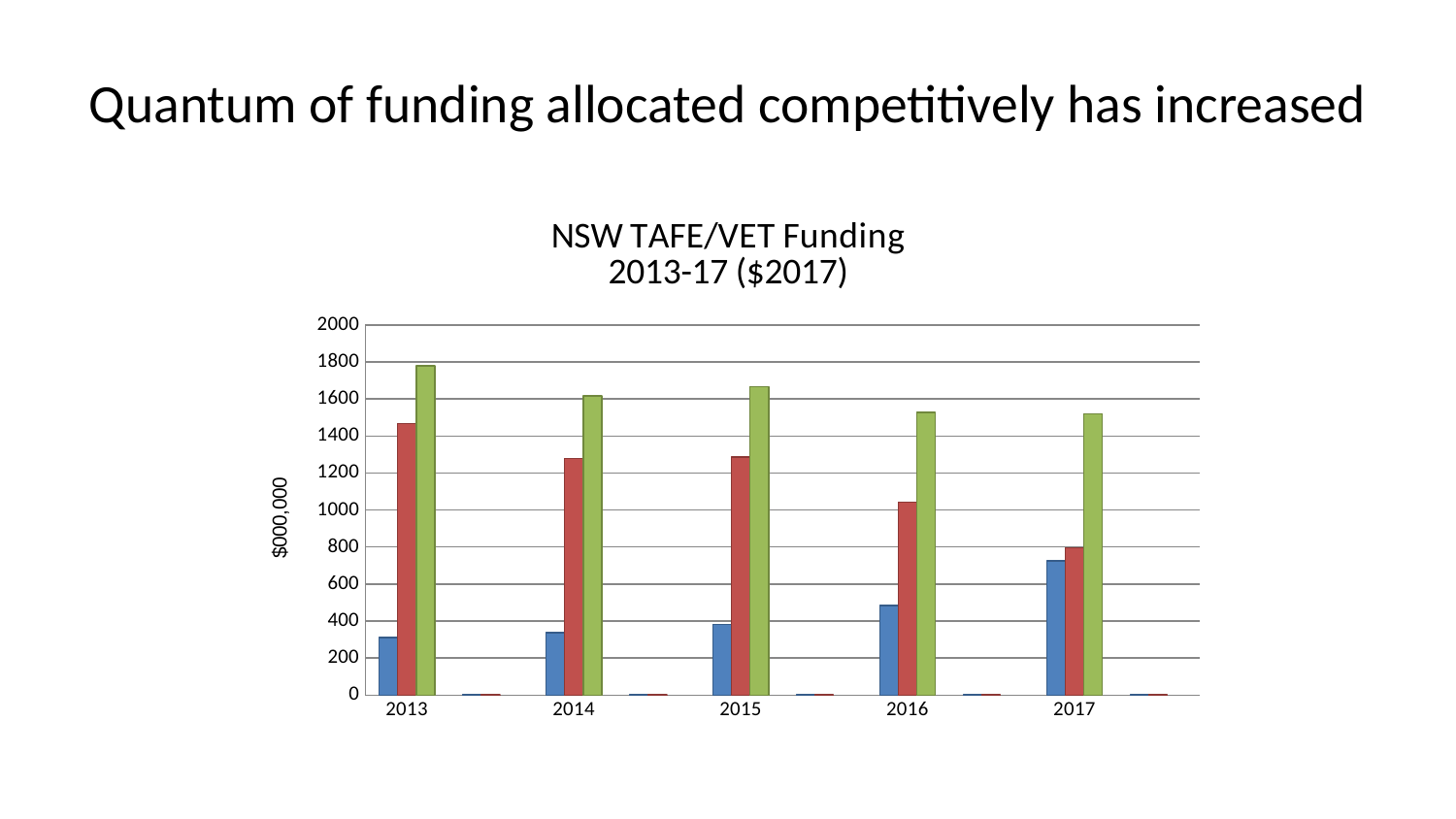
In which year is the blue bar the tallest? 2017 Is the value of the red bar for 2016 greater or less than 1200? less Is the value of the blue bar for 2017 greater or less than 600? greater What is the label on the vertical axis of the chart? $000,000 What is the title of the chart? NSW TAFE/VET Funding 2013-17 ($2017) In which year is the green bar the tallest? 2013 Is the value of the green bar for 2013 greater or less than 1600? greater Do the blue bars rise or fall from 2013 to 2017? Rise In which year is the red bar the shortest? 2017 Which is larger, the red bar for 2013 or the red bar for 2017? The red bar for 2013 How many years are shown along the x axis of the chart? 5 What kind of chart is shown on the slide? Bar chart